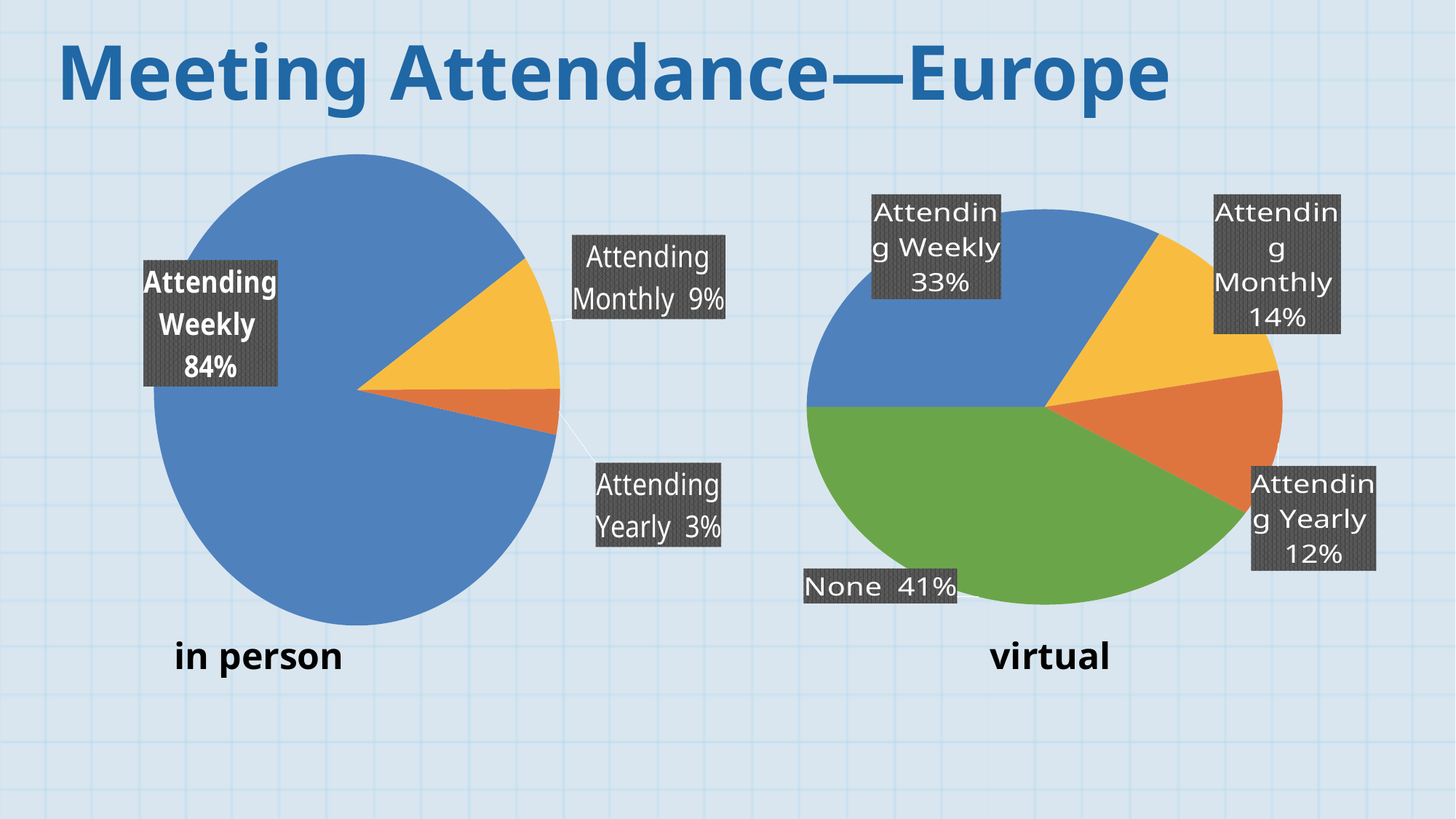
In the 'in person' pie chart, which category has the smallest slice? Attending Yearly In the 'in person' pie chart, what share is labelled for Attending Weekly? 84% In the 'in person' pie chart, what share is labelled for Attending Monthly? 9% In the 'virtual' pie chart, which category has the smallest slice? Attending Yearly What kind of chart is the 'in person' chart? Pie chart In the 'in person' pie chart, what share is labelled for Attending Yearly? 3% In the 'in person' pie chart, which is larger: Attending Monthly or Attending Yearly? Attending Monthly In the 'virtual' pie chart, what share is labelled for Attending Monthly? 14% How many slices does the 'virtual' pie chart have? 4 In the 'virtual' pie chart, what is the difference in percentage points between None and Attending Weekly? 8 In the 'virtual' pie chart, which category has the largest slice? None In the 'virtual' pie chart, what share is labelled for None? 41%